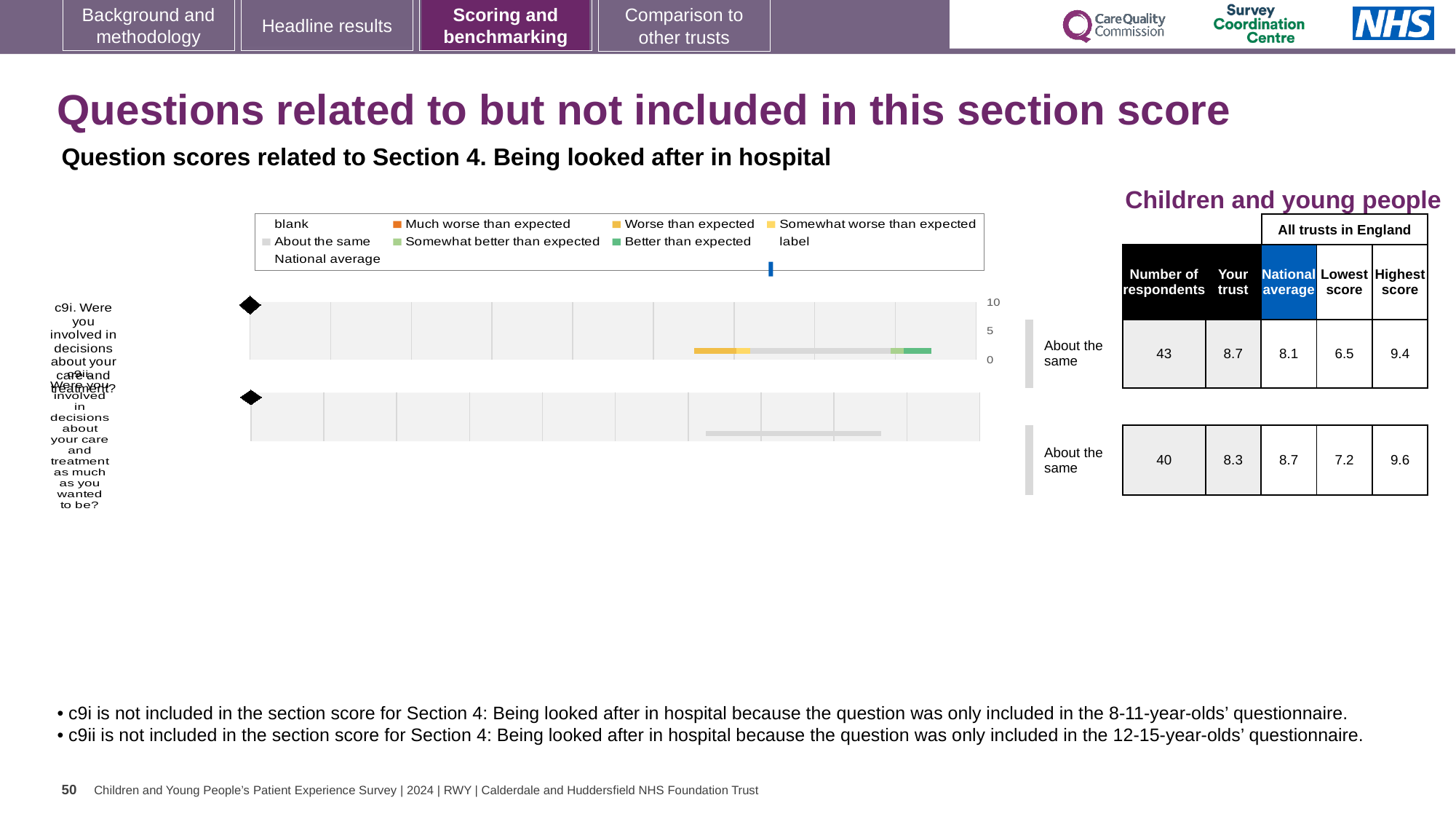
How many entries does the chart legend list? 9 How many questions (rows) are plotted on the slide? 2 What benchmark category is shown for question c9i? About the same What is the 'Your trust' score for question c9i? 8.7 What colour does the legend use for 'Better than expected'? green What is the highest value shown on the chart's score axis? 10 What is the difference between the highest and lowest trust scores for question c9ii? 2.4 What is the lowest score among all trusts in England for question c9ii? 7.2 What kind of chart is used to show the question scores for c9i and c9ii? bar chart What is the national average score for question c9ii? 8.7 For question c9i, which is higher: the trust's score or the national average? Your trust How many respondents answered question c9i? 43